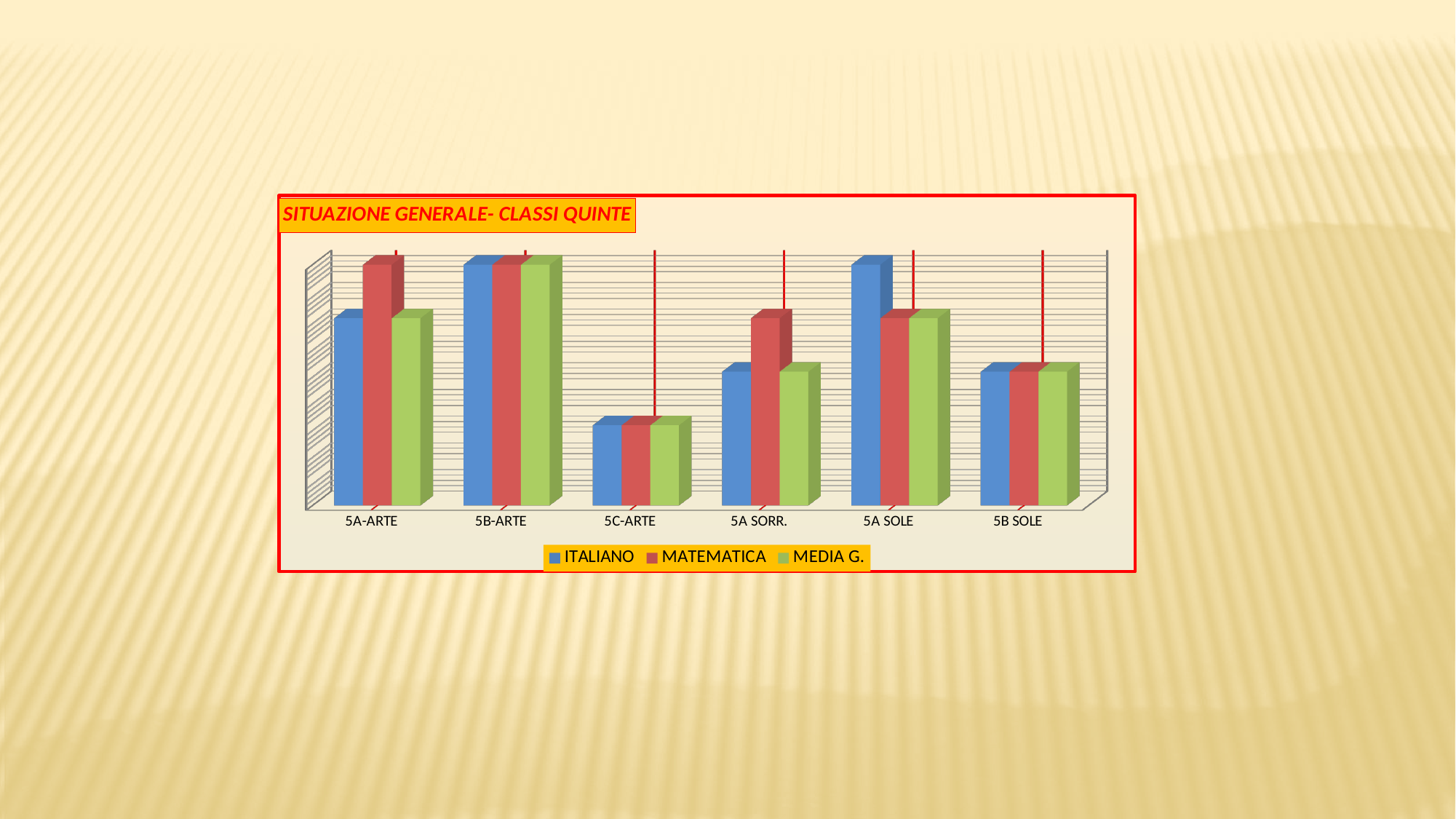
What is the title of the chart? SITUAZIONE GENERALE- CLASSI QUINTE Which series is shown in red in the chart? MATEMATICA What kind of chart is shown on the slide? bar chart Which class has the lowest ITALIANO value? 5C-ARTE How many classes (categories) are shown on the x axis of the chart? 6 For 5A-ARTE, which is larger: ITALIANO or MATEMATICA? MATEMATICA Which class has the lowest MATEMATICA value? 5C-ARTE Which class has the larger ITALIANO value: 5A-ARTE or 5A SORR.? 5A-ARTE How many series does the chart legend list? 3 For 5A SORR., which is larger: ITALIANO or MATEMATICA? MATEMATICA Which class has the highest MEDIA G. value? 5B-ARTE